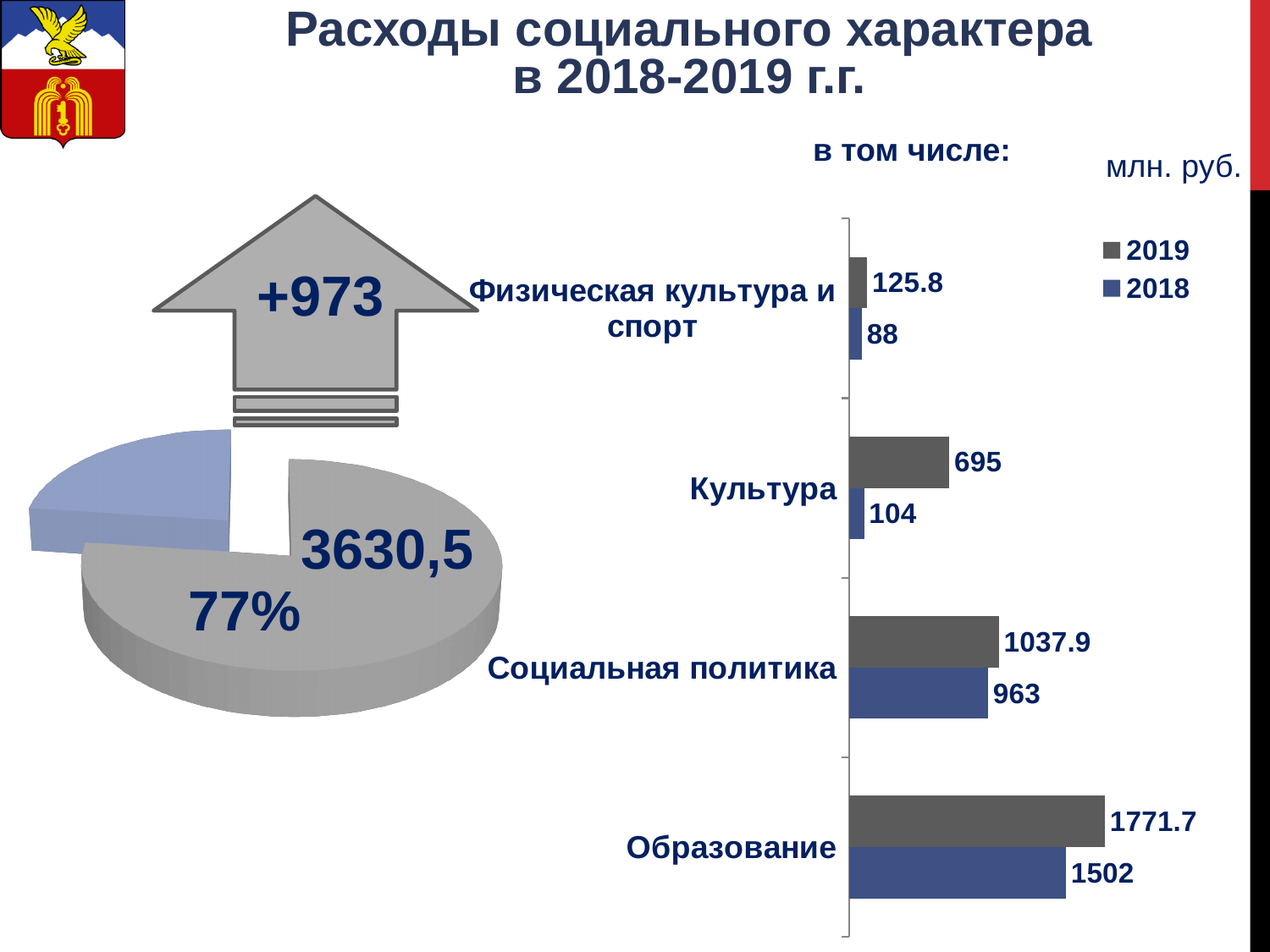
In the bar chart on the right, what is the 2019 value for Образование? 1771.7 In the bar chart on the right, which category has the highest 2019 value? Образование How many series does the legend of the bar chart on the right list? 2 In the bar chart on the right, what is the 2019 value for Социальная политика? 1037.9 In the bar chart on the right, what is the 2018 value for Физическая культура и спорт? 88 In the bar chart on the right, what is the difference between the 2019 and 2018 values for Образование? 269.7 How many categories does the bar chart on the right show? 4 In the bar chart on the right, which category has the lowest 2018 value? Физическая культура и спорт In the bar chart on the right, which is larger for Социальная политика: the 2019 value or the 2018 value? 2019 In the bar chart on the right, what is the 2018 value for Культура? 104 In the bar chart on the right, what is the difference between the 2019 and 2018 values for Культура? 591 In the pie chart on the left, what share does the grey slice labelled 3630,5 represent? 77%